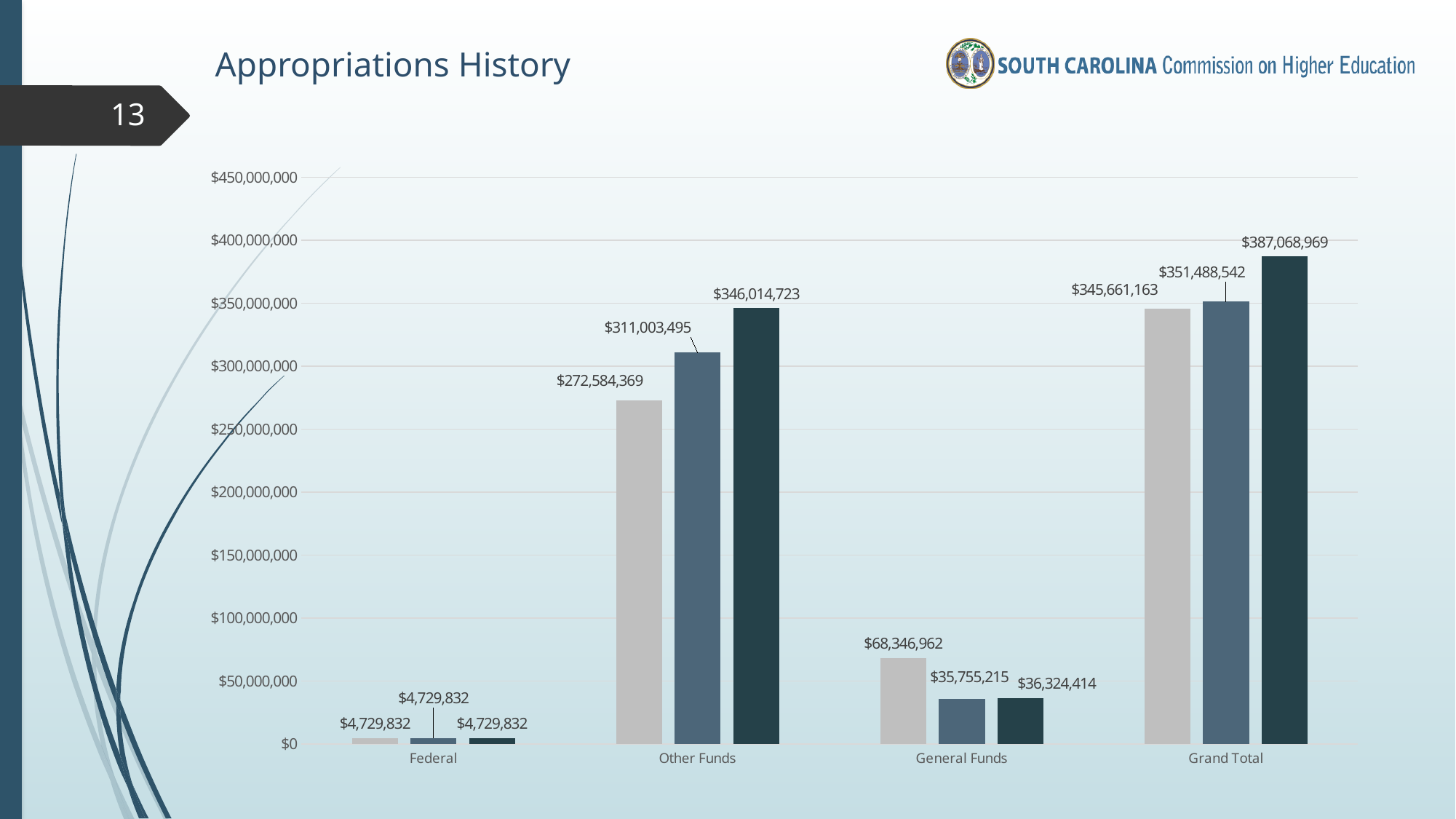
What is the difference between the dark teal bar and the light gray bar for Other Funds? $73,430,354 For General Funds, which is larger: the light gray bar or the dark teal bar? the light gray bar What is the value of the medium blue (middle) bar for General Funds? $35,755,215 Which category has the highest bar in the chart? Grand Total What kind of chart is shown on the slide? bar chart What is the value of the dark teal (rightmost) bar for Grand Total? $387,068,969 Do the values for Other Funds rise or fall from the left bar to the right bar? rise What is the title of the chart? Appropriations History How many bars are plotted for each category in the chart? 3 How many categories are shown on the x axis of the chart? 4 What is the value of the light gray (leftmost) bar for Other Funds? $272,584,369 Which category has the lowest values in the chart? Federal